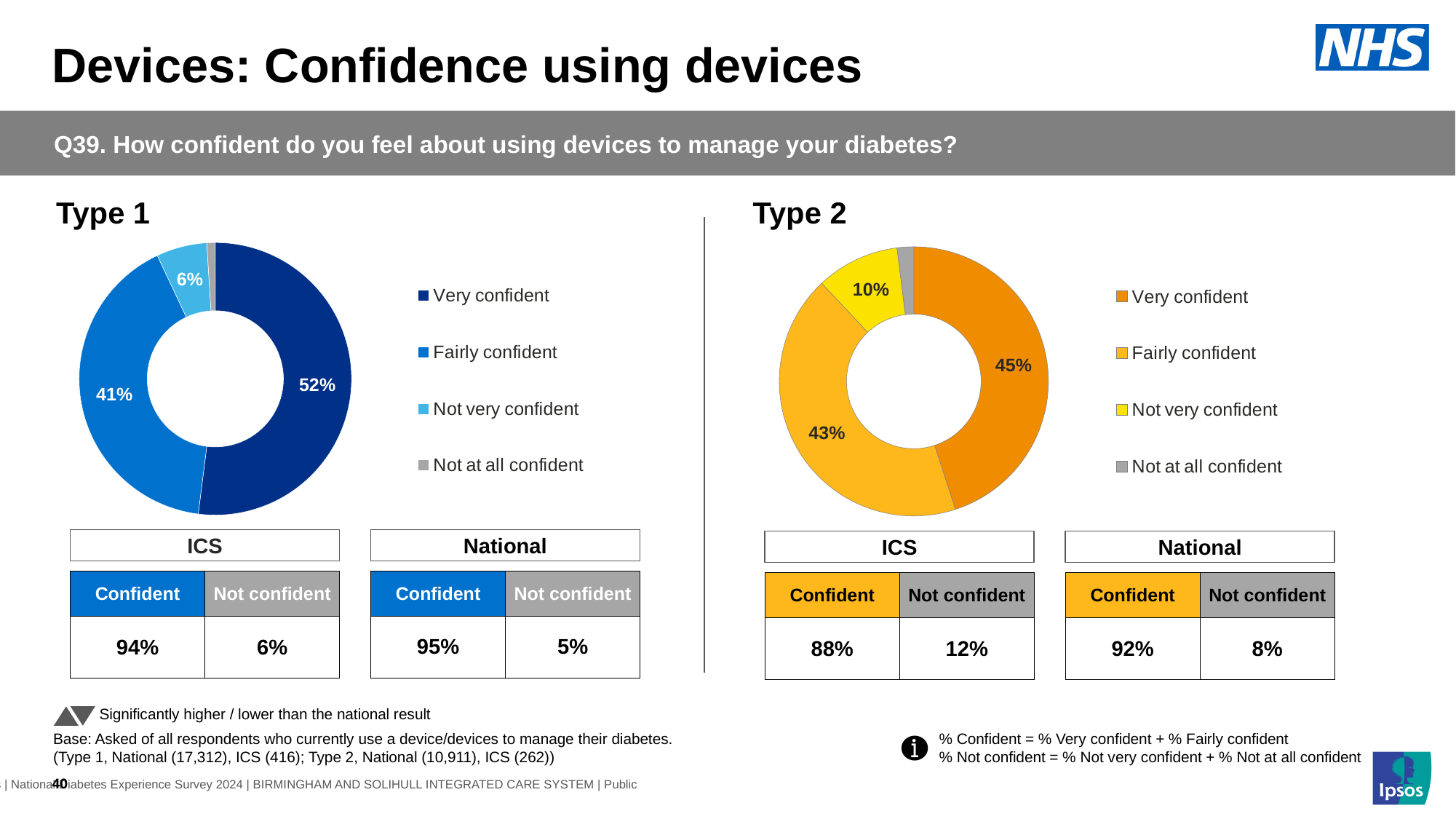
What kind of chart is used for Type 1? Donut chart In the Type 2 chart, which category has the smallest share? Not at all confident In the Type 2 chart, is the share for not very confident larger or smaller than the share for fairly confident? smaller In the Type 1 chart, what is the difference between the very confident and fairly confident shares? 11% In the Type 1 chart, which category has the largest share? Very confident In the Type 2 chart, what percentage of respondents are not very confident? 10% In the Type 1 chart, what percentage of respondents are very confident? 52% In the Type 2 chart, what is the combined share of very confident and fairly confident? 88% In the Type 2 chart, what percentage of respondents are very confident? 45% How many categories does the legend of the Type 2 chart list? 4 In the Type 1 chart, what percentage of respondents are fairly confident? 41% In the Type 1 chart, what colour represents the very confident category? Dark blue